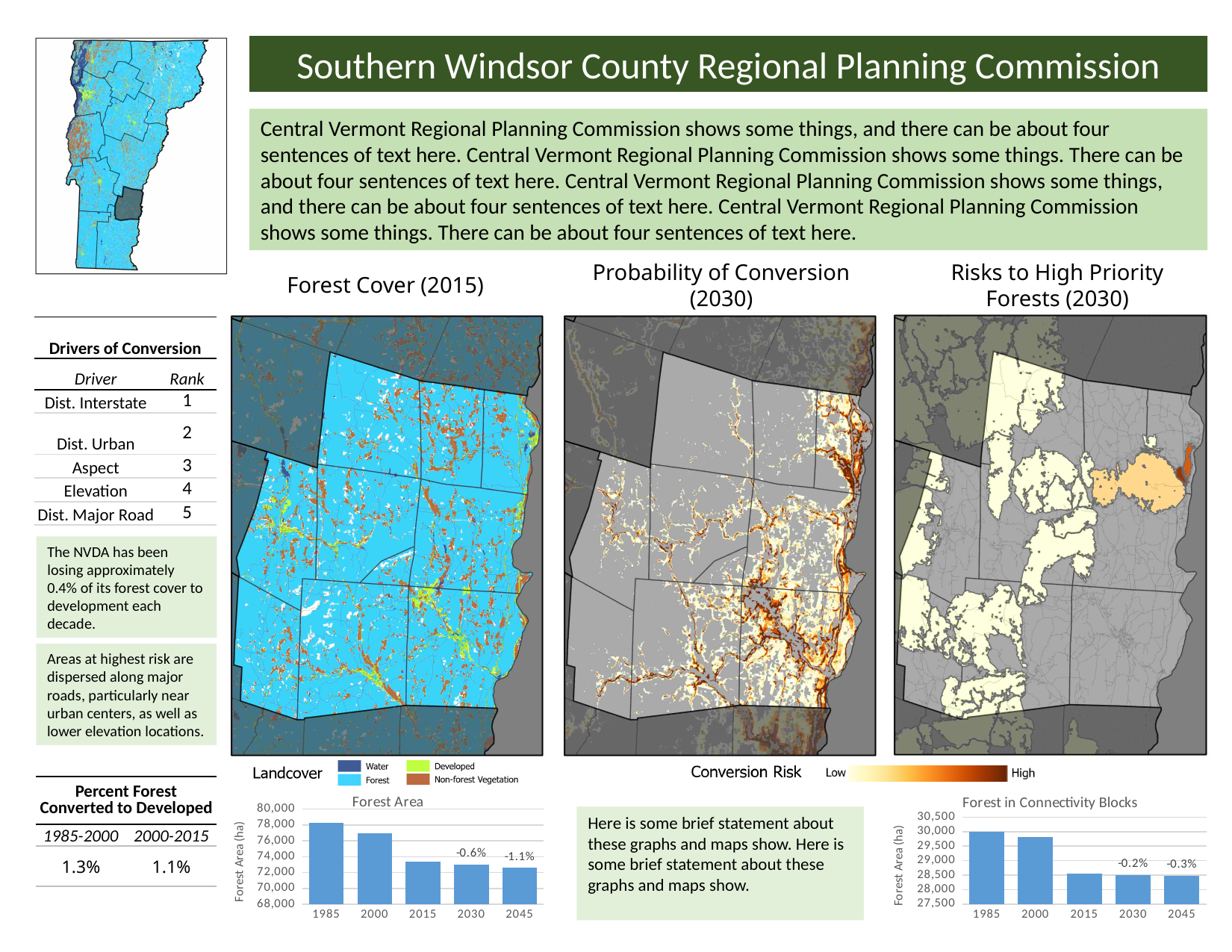
How many years are shown on the x axis of the 'Forest Area' chart? 5 In the 'Forest Area' chart, is the value for 2015 greater or less than 74,000? less In the 'Forest Area' chart, which year has the highest forest area? 1985 In the 'Forest Area' chart, is the value for 2000 greater or less than 76,000? greater In the 'Forest in Connectivity Blocks' chart, is the value for 2000 greater or less than 30,000? less In the 'Forest Area' chart, what percentage change label is shown above the 2030 bar? -0.6% What kind of chart is the 'Forest Area' chart? bar chart In the 'Forest in Connectivity Blocks' chart, which year has the highest value? 1985 In the 'Forest in Connectivity Blocks' chart, what percentage change label is shown above the 2045 bar? -0.3% What is the y-axis label of the 'Forest in Connectivity Blocks' chart? Forest Area (ha) In the 'Forest Area' chart, what percentage change label is shown above the 2045 bar? -1.1% In the 'Forest Area' chart, do the values rise or fall from 1985 to 2045? fall